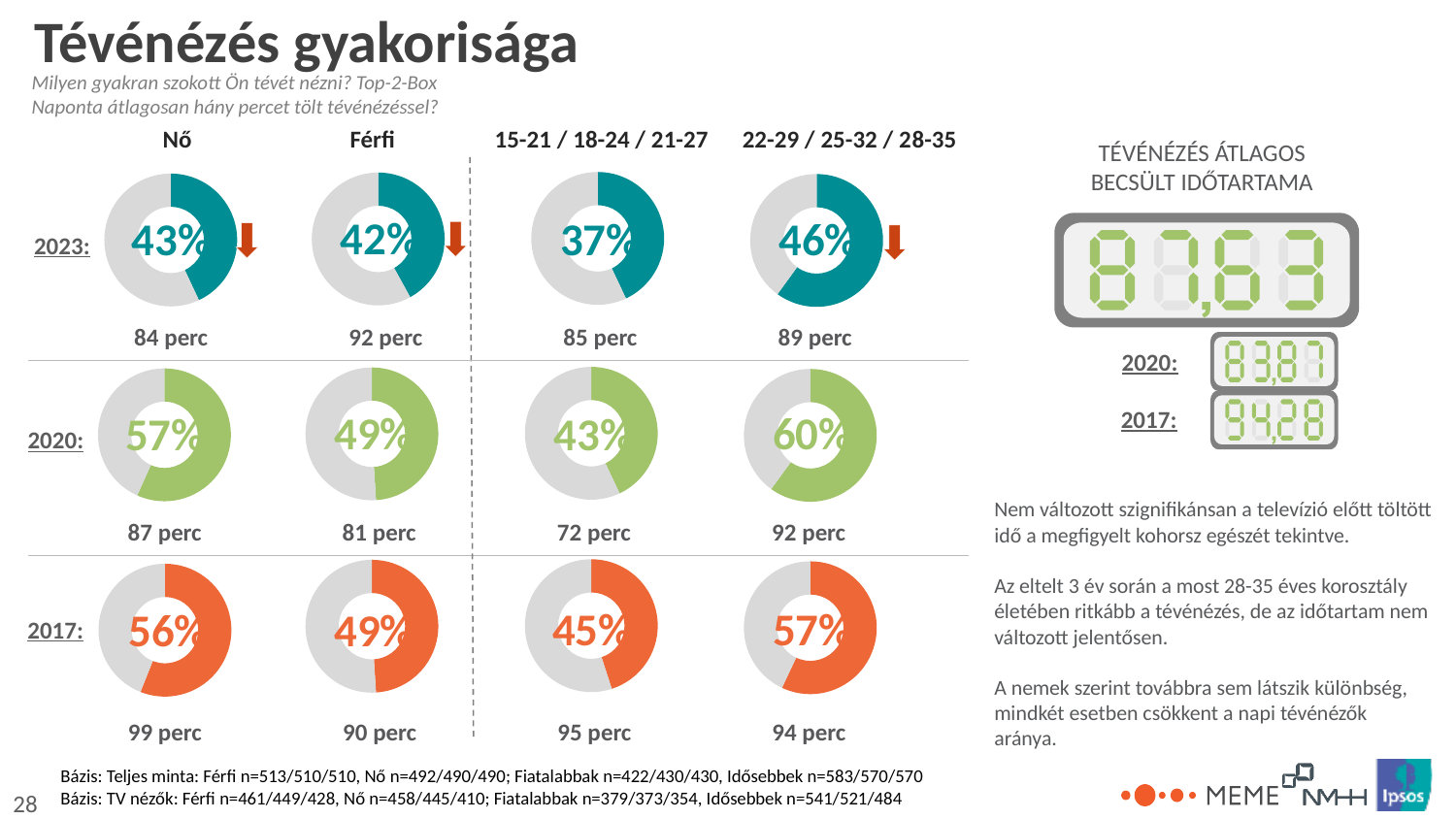
What type of chart is used to show the percentages for each group and year? Donut (pie) chart In the 2023 row, which group has the lowest percentage among the four donut charts? 15-21 / 18-24 / 21-27 In the 2023 row, how many minutes (perc) are shown under the Férfi donut chart? 92 perc What is the difference in minutes between the 2017 Férfi value (90 perc) and the 2020 Férfi value (81 perc)? 9 perc In the 2017 row, how many minutes (perc) are shown under the Nő donut chart? 99 perc In the 2020 row, what percentage is shown in the donut chart for the 22-29 / 25-32 / 28-35 group? 60% In the 2017 row, which is larger: the percentage for Nő or the percentage for Férfi? Nő In the 2023 row, what percentage is shown in the donut chart for Nő? 43% How many donut charts are shown in the grid on the slide? 12 What is the difference in percentage points between the Nő donut chart in 2020 and the Nő donut chart in 2023? 14 What colour are the donut charts in the 2017 row? Orange In the 2020 row, which group has the highest percentage among the four donut charts? 22-29 / 25-32 / 28-35